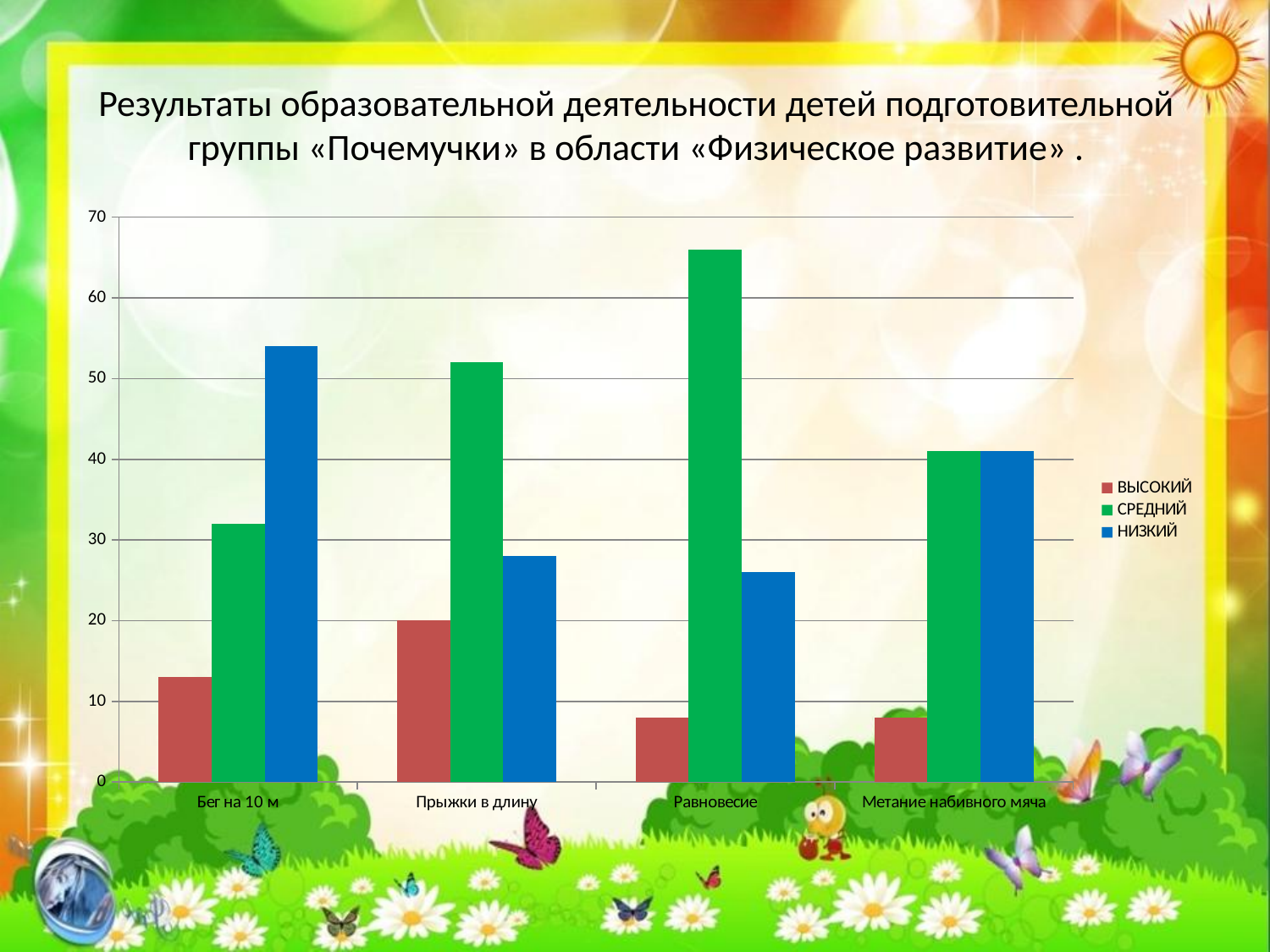
Which category has the highest НИЗКИЙ value? Бег на 10 м For Прыжки в длину, which is larger: the СРЕДНИЙ value or the НИЗКИЙ value? СРЕДНИЙ Which category has the highest ВЫСОКИЙ value? Прыжки в длину Is the НИЗКИЙ value for Бег на 10 м greater or less than 50? greater What kind of chart is shown on the slide? bar chart Is the ВЫСОКИЙ value for Равновесие greater or less than 10? less How many series does the legend list? 3 How many categories are shown along the x axis? 4 Is the СРЕДНИЙ value for Равновесие greater or less than 60? greater Which series is shown in blue in the legend? НИЗКИЙ Which category has the lowest СРЕДНИЙ value? Бег на 10 м Which category has the highest СРЕДНИЙ value? Равновесие